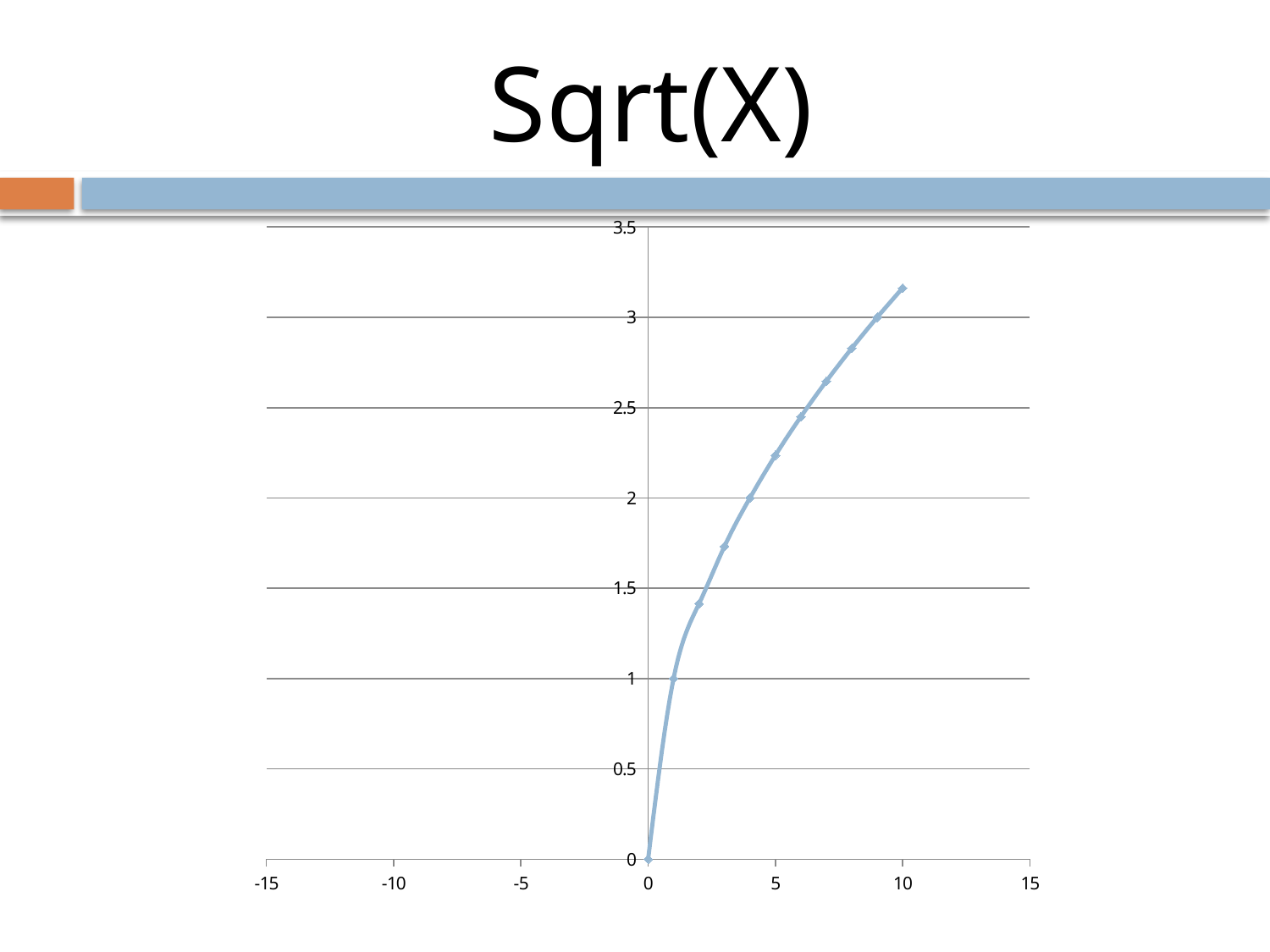
What is the plotted value at x = 4? 2 At which x value is the plotted value lowest? 0 What is the plotted value at x = 0? 0 How many data points are plotted on the curve? 11 Do the plotted values rise or fall as x increases from 0 to 10? rise What is the plotted value at x = 1? 1 What is the plotted value at x = 9? 3 At which x value is the plotted value highest? 10 Is the value at x = 2 greater or less than 1.5? less What is the title of the slide/chart? Sqrt(X) What kind of chart is shown on the slide? line chart Is the value at x = 10 greater or less than 3? greater